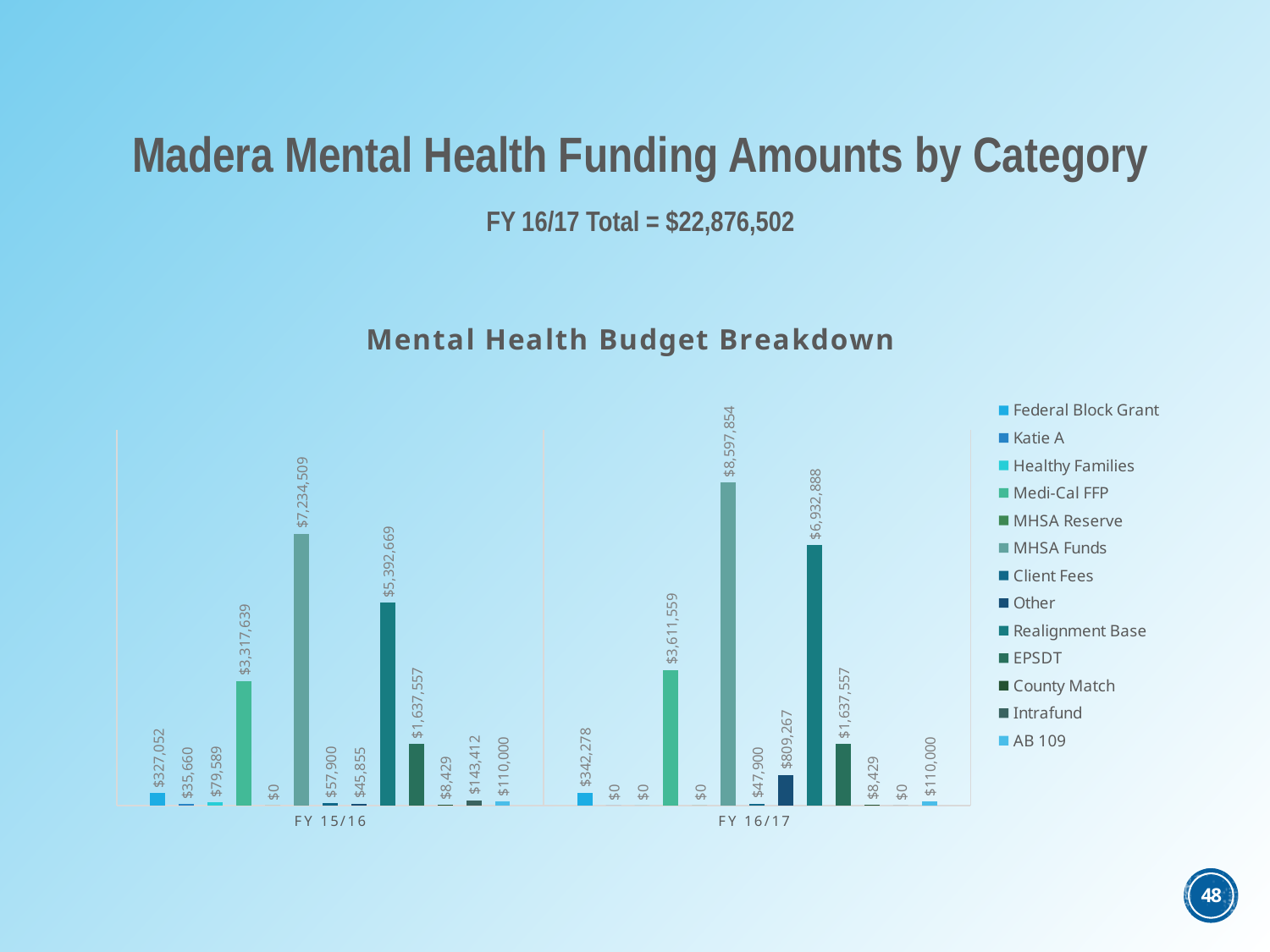
What is the title of the chart? Mental Health Budget Breakdown How many fiscal year categories are shown on the x axis? 2 What is the difference between MHSA Funds in FY 16/17 and MHSA Funds in FY 15/16? $1,363,345 Which is larger: Realignment Base in FY 16/17 or Medi-Cal FFP in FY 16/17? Realignment Base in FY 16/17 What is the value of Federal Block Grant for FY 15/16? $327,052 What is the value of MHSA Funds for FY 16/17? $8,597,854 Which funding category has the highest value in FY 15/16? MHSA Funds What kind of chart is shown on the slide? Bar chart How many series does the legend list? 13 Which funding category has the highest value in FY 16/17? MHSA Funds What is the value of Realignment Base for FY 15/16? $5,392,669 What is the value of Medi-Cal FFP for FY 16/17? $3,611,559